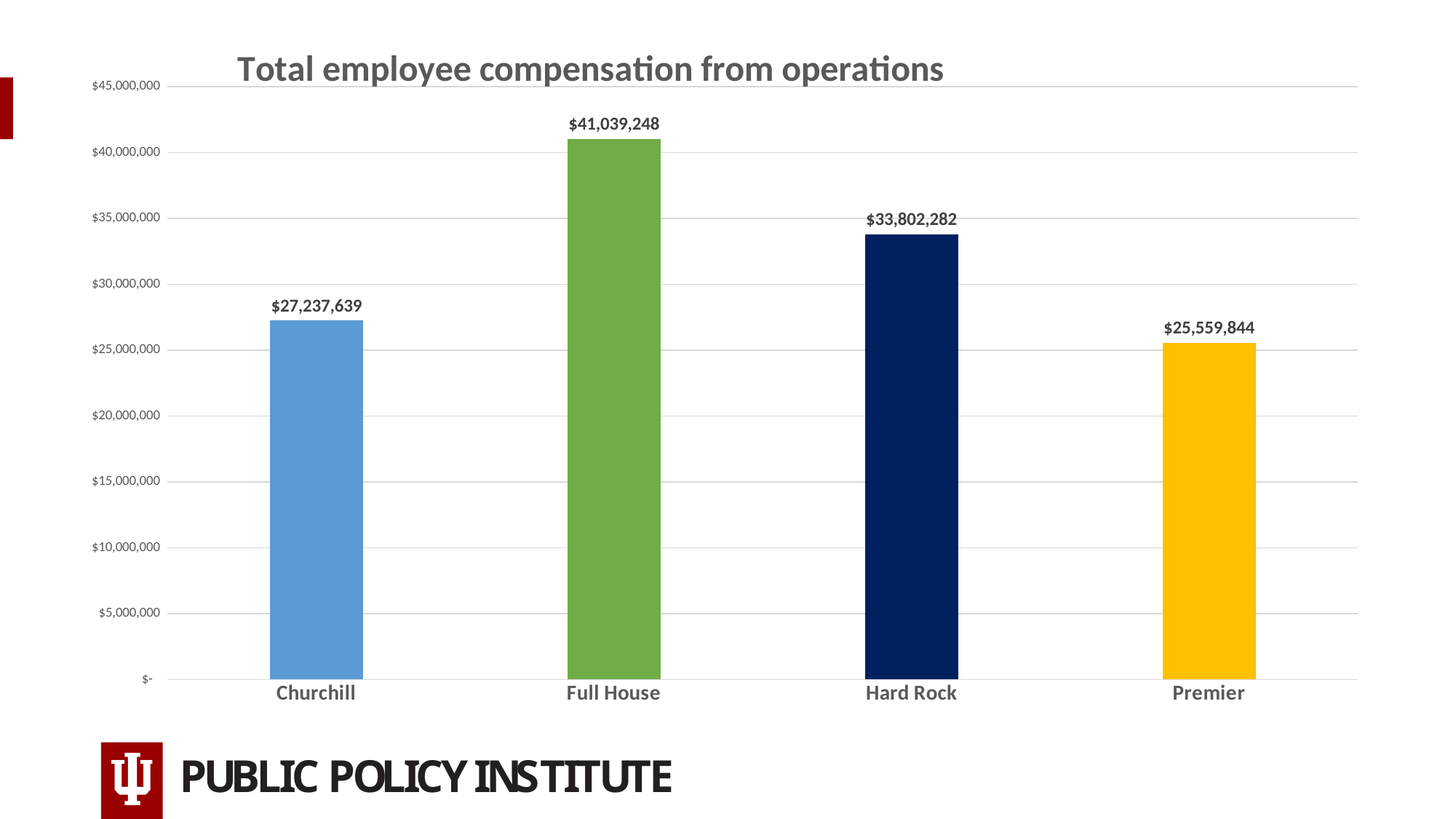
What is the total employee compensation from operations for Full House? $41,039,248 What is the difference between Hard Rock's and Premier's total employee compensation from operations? $8,242,438 What is the total employee compensation from operations for Churchill? $27,237,639 What kind of chart is shown on the slide? Bar chart Which company has the highest total employee compensation from operations? Full House How many companies are shown in the chart? 4 What is the title of the chart? Total employee compensation from operations Which has a larger total employee compensation from operations, Hard Rock or Churchill? Hard Rock Which company has the lowest total employee compensation from operations? Premier What is the total employee compensation from operations for Premier? $25,559,844 Is the value for Hard Rock greater or less than $30,000,000? greater What is the difference between Full House's and Churchill's total employee compensation from operations? $13,801,609